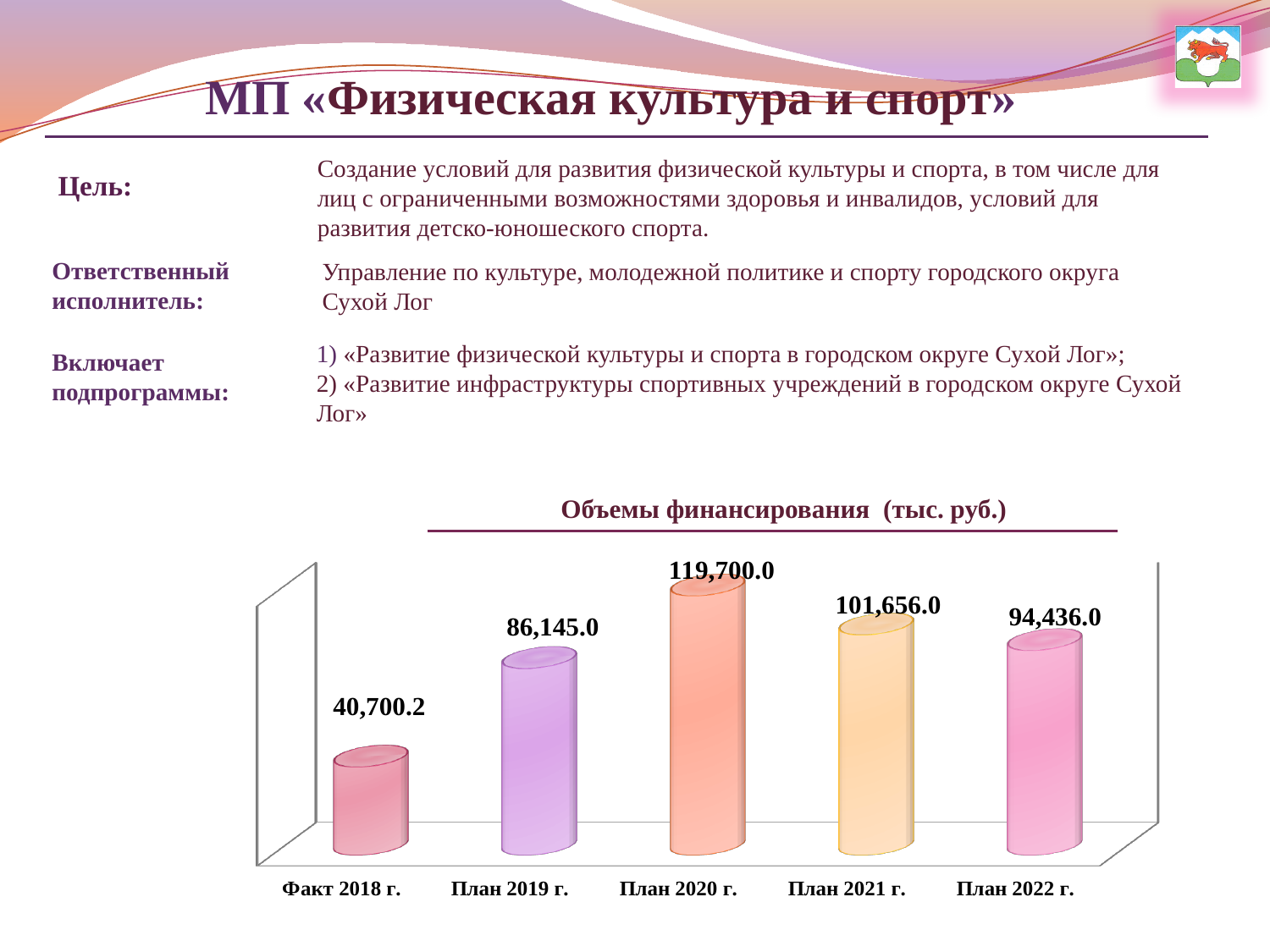
Which is larger, the value for План 2021 г. or the value for План 2022 г.? План 2021 г. What is the value for План 2022 г. in the chart? 94,436.0 Which category has the highest value in the chart? План 2020 г. What is the difference between the values for План 2019 г. and Факт 2018 г.? 45,444.8 How many categories are shown in the chart? 5 What is the title of the chart? Объемы финансирования (тыс. руб.) What is the value for План 2019 г. in the chart? 86,145.0 What is the value for План 2021 г. in the chart? 101,656.0 What kind of chart is shown on the slide? Bar chart Which category has the lowest value in the chart? Факт 2018 г. What is the value for Факт 2018 г. in the chart? 40,700.2 What is the difference between the values for План 2020 г. and План 2021 г.? 18,044.0